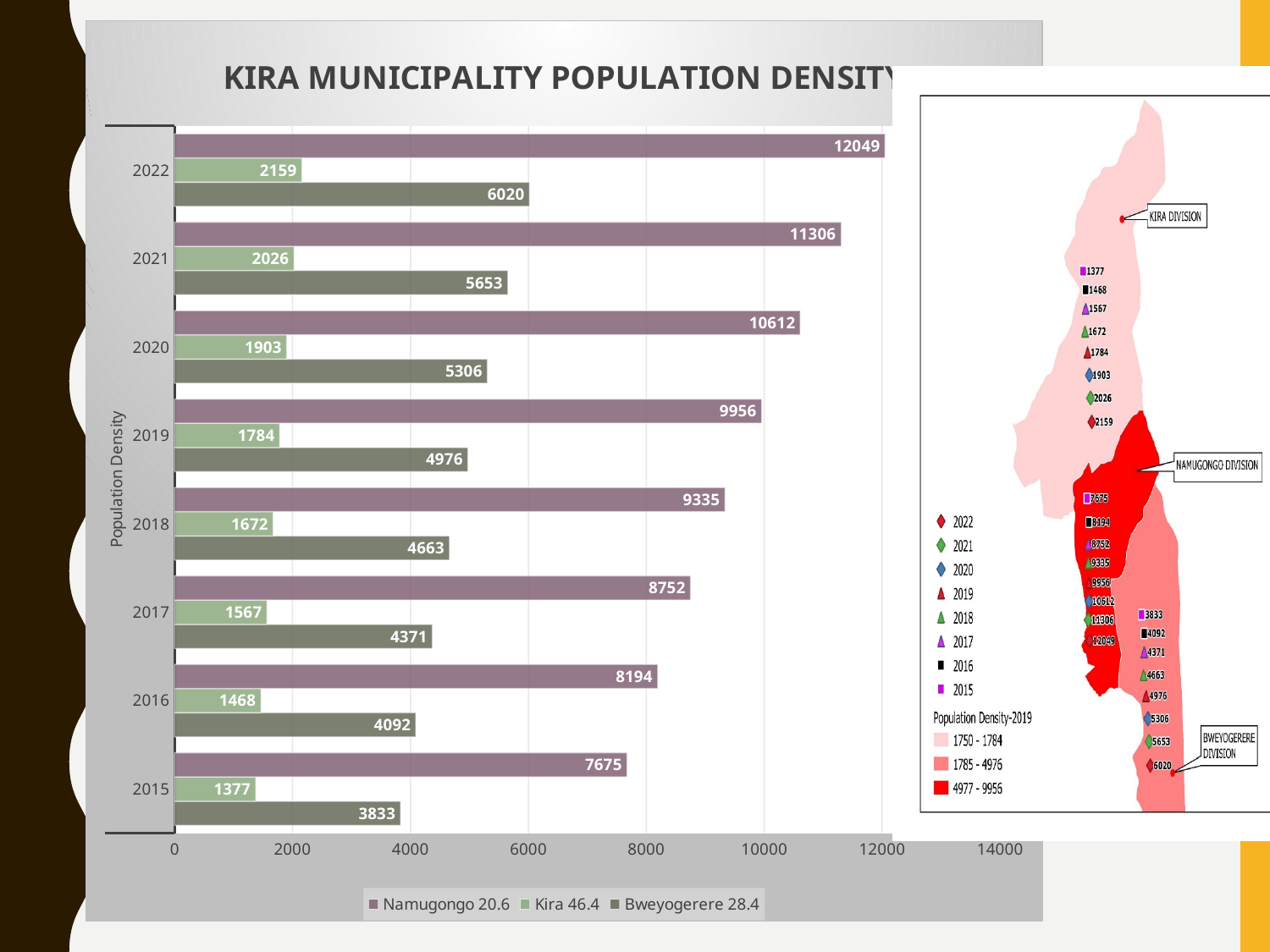
What is the population density value for Namugongo in 2022? 12049 In which year is the Namugongo value highest? 2022 How many series does the legend list? 3 Do the Kira values rise or fall from 2015 to 2022? rise Is the Namugongo value for 2019 greater or less than 8000? greater What kind of chart is shown on the slide? bar chart What is the population density value for Kira in 2015? 1377 What is the population density value for Bweyogerere in 2019? 4976 How many years are shown on the chart? 8 What is the difference between the Namugongo values for 2022 and 2021? 743 Which is larger in 2020: the Kira value or the Bweyogerere value? Bweyogerere In which year is the Bweyogerere value lowest? 2015